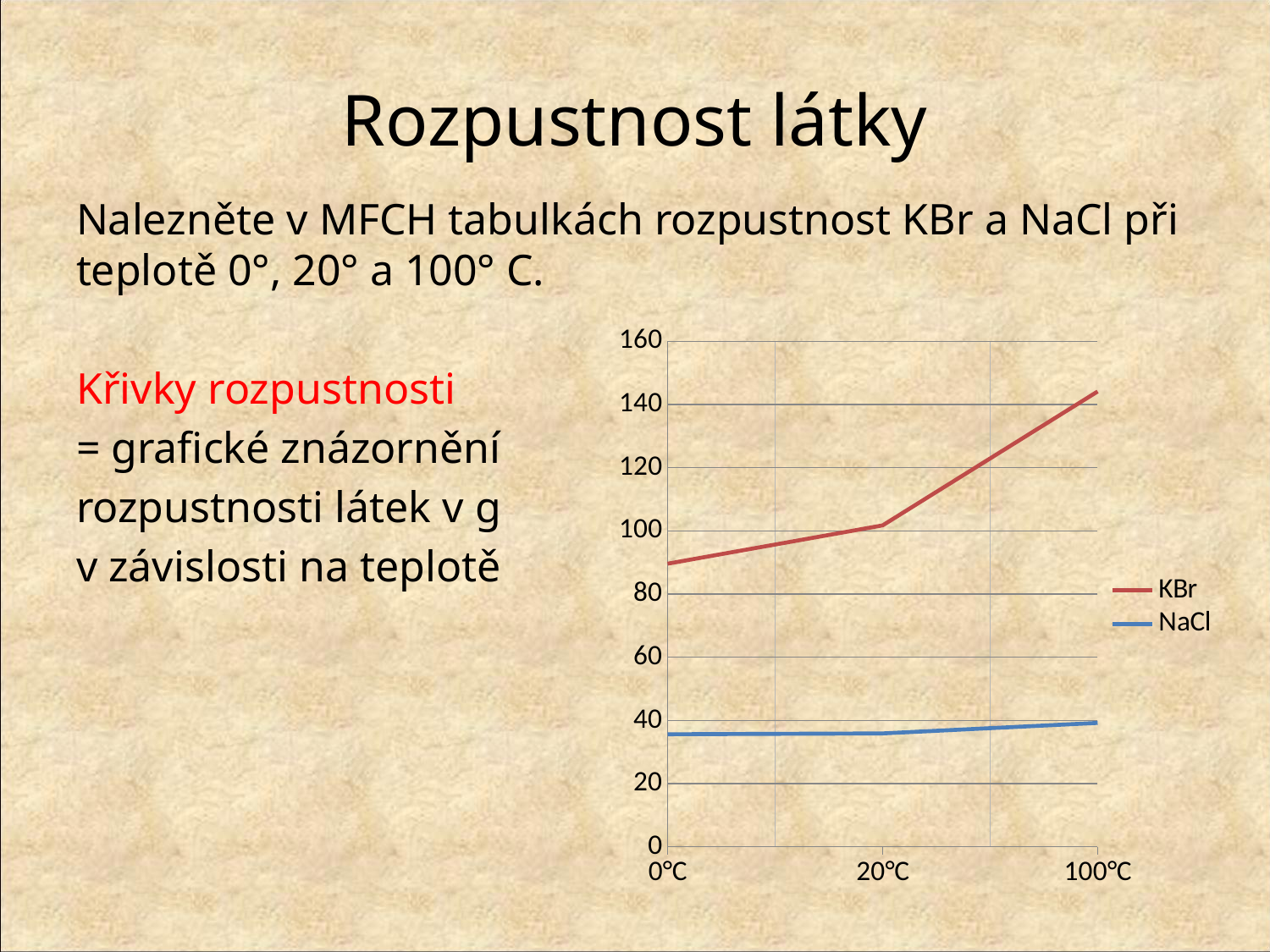
Which series is drawn with the red line? KBr At which temperature does KBr reach its highest value? 100°C Is the value for NaCl at 100°C greater or less than 60? less Is the value for KBr at 100°C greater or less than 120? greater Is the value for NaCl at 0°C greater or less than 40? less What are the two entries in the chart legend? KBr and NaCl Which series has the larger value at 20°C, KBr or NaCl? KBr How many temperature points are plotted along the x axis? 3 How many series does the chart legend list? 2 Does the KBr line rise or fall as temperature increases from 0°C to 100°C? rises What kind of chart is shown on the slide? line chart